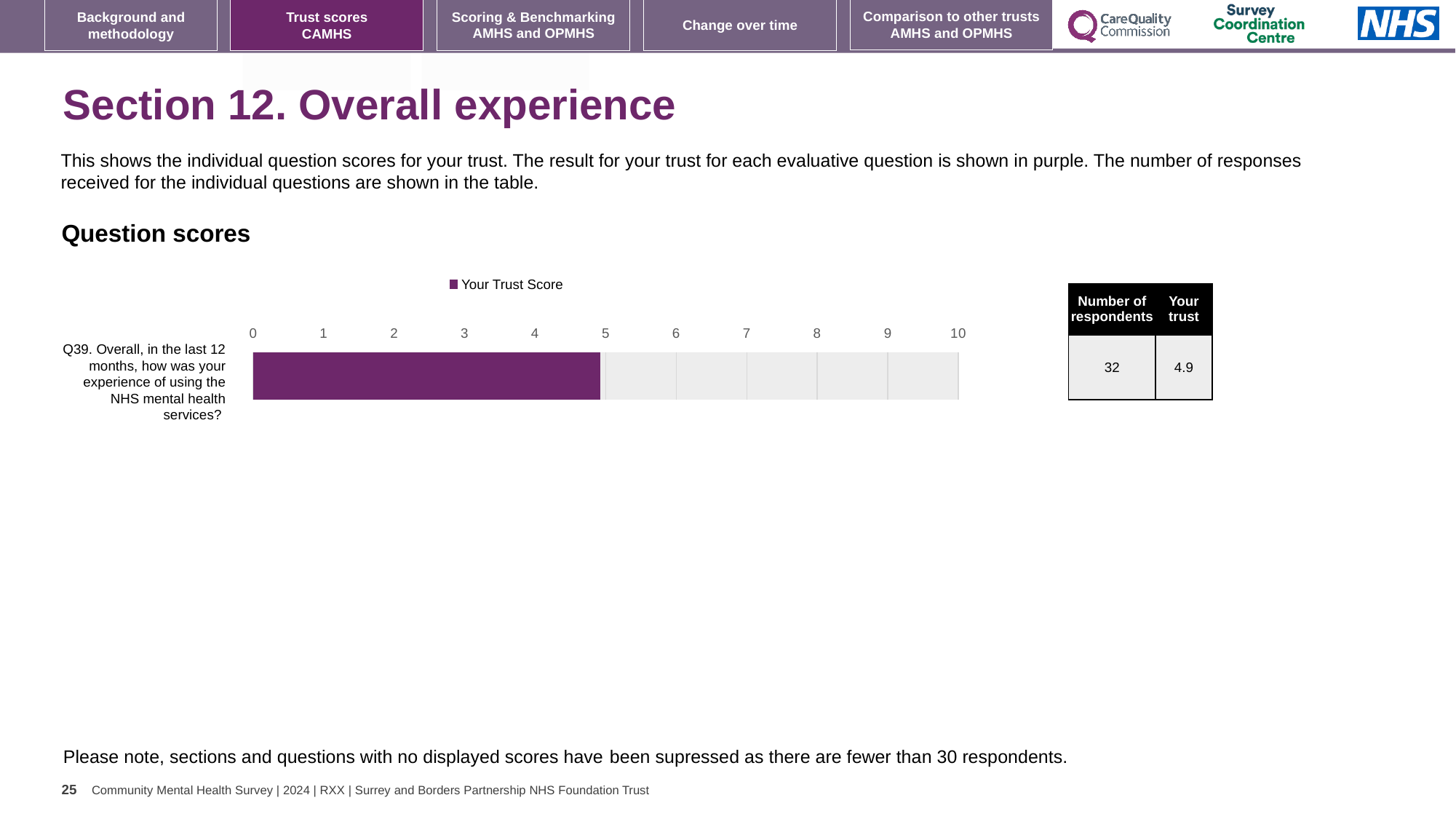
What is the name of the series shown in the legend of the Question scores chart? Your Trust Score Is the trust score for Q39 greater or less than 4? greater What kind of chart is shown under 'Question scores'? bar chart How many series does the legend of the Question scores chart list? 1 What is the maximum value shown on the x axis of the Question scores chart? 10 How many respondents answered Q39 according to the table next to the chart? 32 How many questions (categories) are plotted in the Question scores chart? 1 Which question is plotted in the Question scores chart? Q39. Overall, in the last 12 months, how was your experience of using the NHS mental health services? What is the trust score for Q39 as shown in the table next to the chart? 4.9